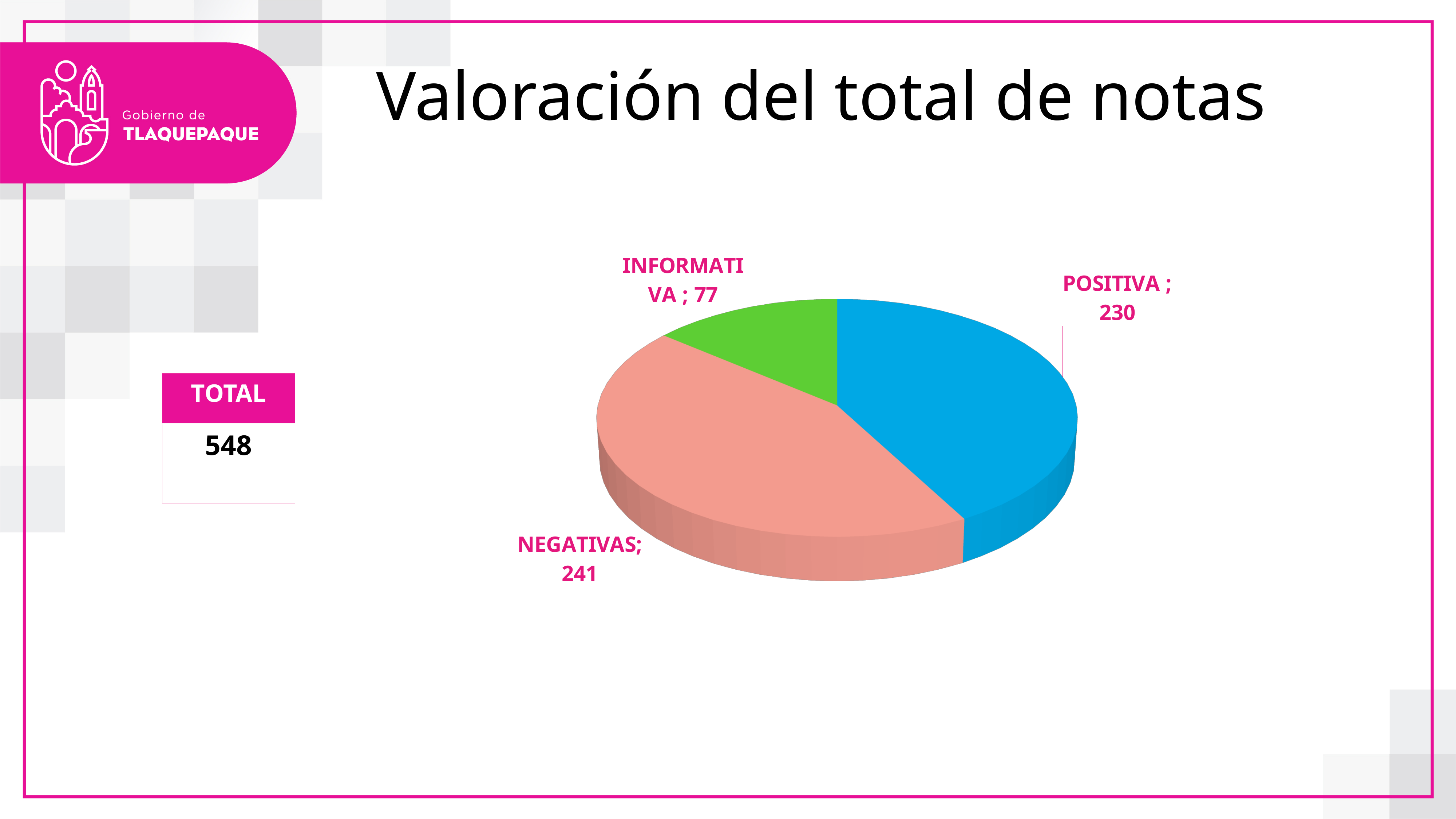
What kind of chart is shown on the slide? Pie chart What is the total of all the slices in the pie chart? 548 Which category has the smallest slice in the pie chart? INFORMATIVA How many slices does the pie chart have? 3 What is the value for NEGATIVAS in the pie chart? 241 Which is larger, the value for POSITIVA or the value for INFORMATIVA? POSITIVA What is the difference between the NEGATIVAS and POSITIVA values? 11 What is the value for INFORMATIVA in the pie chart? 77 Which category has the largest slice in the pie chart? NEGATIVAS What is the difference between the POSITIVA and INFORMATIVA values? 153 What is the title of the slide containing the pie chart? Valoración del total de notas What is the value for POSITIVA in the pie chart? 230